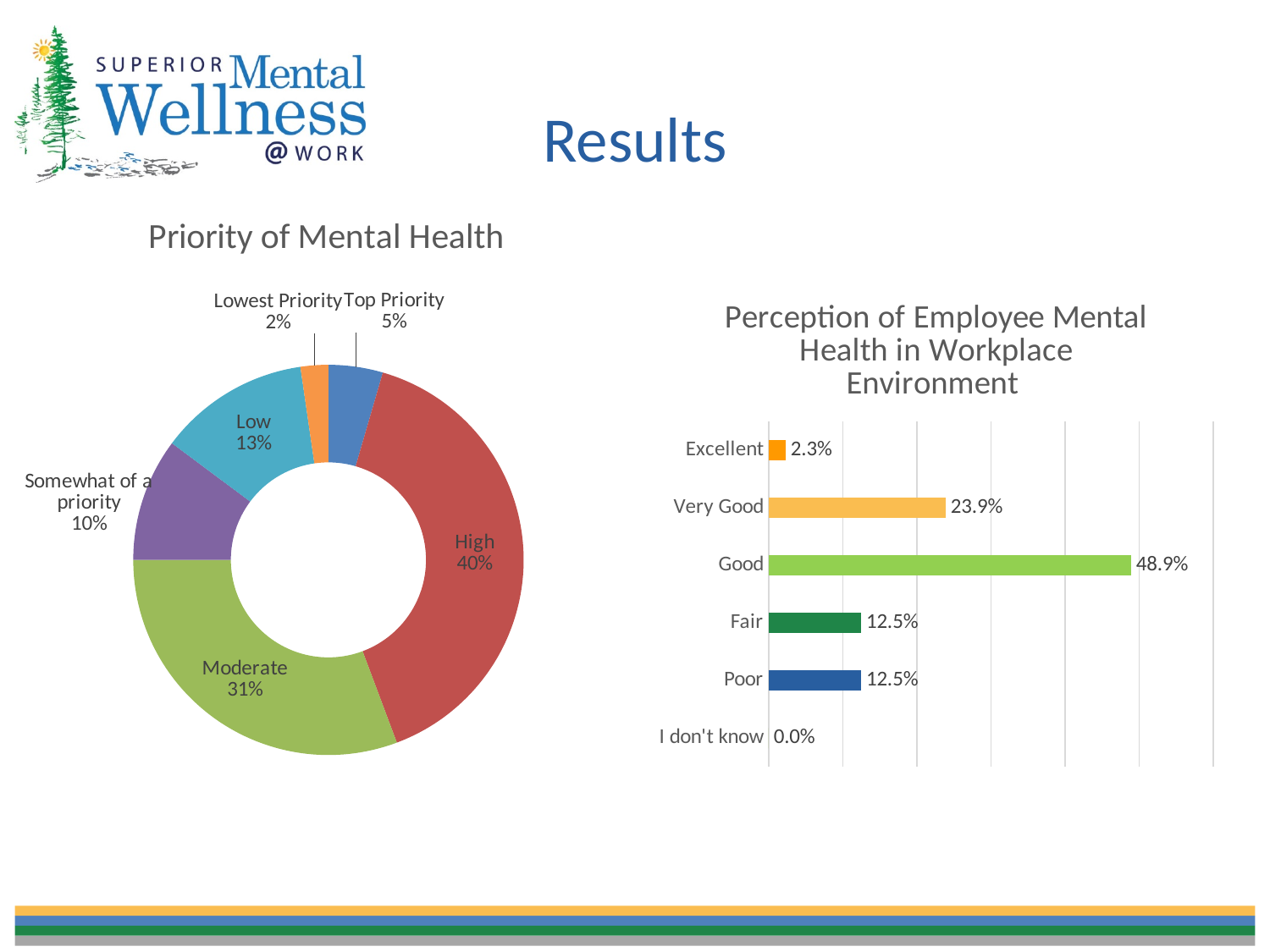
In the 'Priority of Mental Health' chart, what percentage is shown for Somewhat of a priority? 10% In the 'Perception of Employee Mental Health in Workplace Environment' chart, what is the value for Very Good? 23.9% In the 'Perception of Employee Mental Health in Workplace Environment' chart, which category has the highest value? Good In the 'Perception of Employee Mental Health in Workplace Environment' chart, what is the value for Good? 48.9% What kind of chart is the 'Perception of Employee Mental Health in Workplace Environment' chart? Bar chart In the 'Priority of Mental Health' chart, what percentage is shown for High? 40% In the 'Priority of Mental Health' chart, what is the difference between the Moderate and Low shares? 18% What kind of chart is the 'Priority of Mental Health' chart? Doughnut chart In the 'Priority of Mental Health' chart, how many categories are shown? 6 In the 'Perception of Employee Mental Health in Workplace Environment' chart, what is the difference between Good and Very Good? 25.0% In the 'Priority of Mental Health' chart, which category has the largest share? High In the 'Priority of Mental Health' chart, which category has the smallest share? Lowest Priority